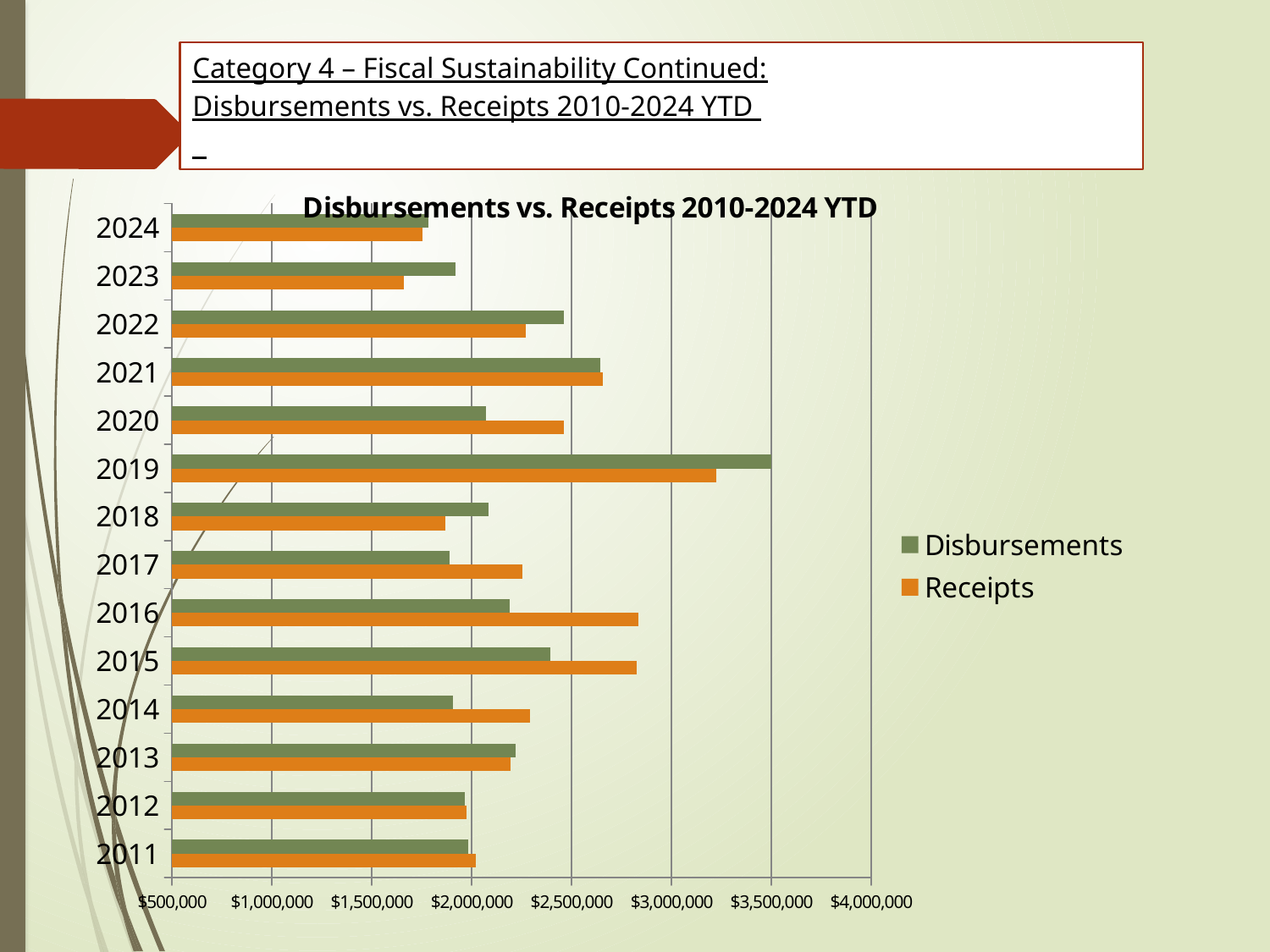
Which year has the lowest Receipts value? 2023 In 2016, which is larger, Disbursements or Receipts? Receipts Is the Receipts value for 2016 greater or less than $2,500,000? greater In 2023, which is larger, Disbursements or Receipts? Disbursements Is the Disbursements value for 2019 greater or less than $3,000,000? greater Which year has the highest Disbursements value? 2019 Which year has the highest Receipts value? 2019 What is the title of the chart? Disbursements vs. Receipts 2010-2024 YTD What kind of chart is shown on the slide? Bar chart How many years are shown on the chart's vertical axis? 14 How many series does the legend list? 2 Is the Receipts value for 2023 greater or less than $2,000,000? less